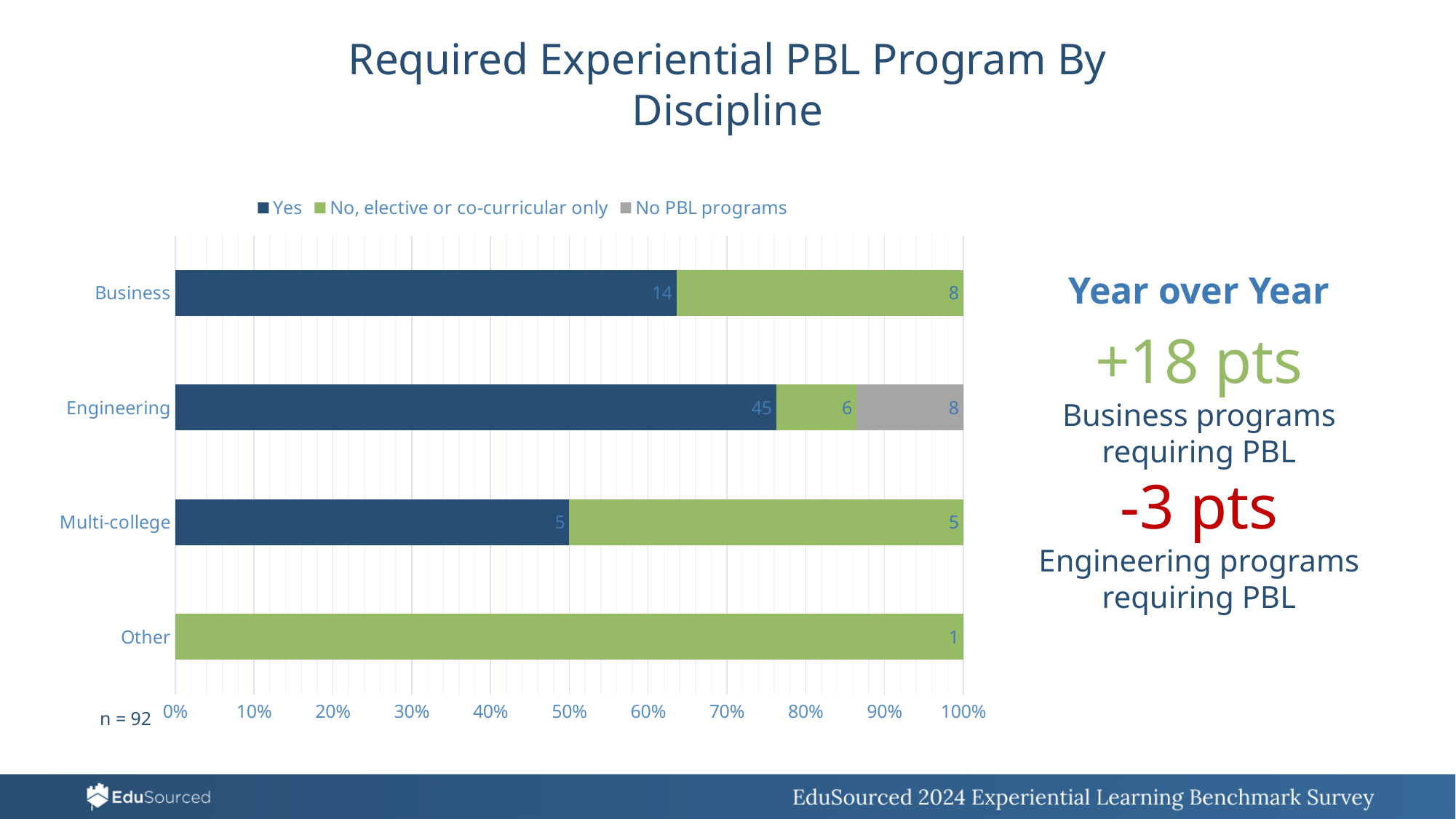
What is the 'No PBL programs' value for Engineering? 8 What is the sample size shown below the chart? n = 92 How many disciplines are shown on the chart? 4 How many series does the legend list? 3 What is the difference between the 'Yes' values for Engineering and Business? 31 What is the total of the Engineering bar? 59 What is the 'No, elective or co-curricular only' value for Business? 8 Which discipline has the highest 'Yes' value? Engineering What is the 'Yes' value for Engineering? 45 Which is larger for Business: the 'Yes' value or the 'No, elective or co-curricular only' value? Yes What kind of chart is shown? Stacked bar chart What is the total of the Business bar? 22